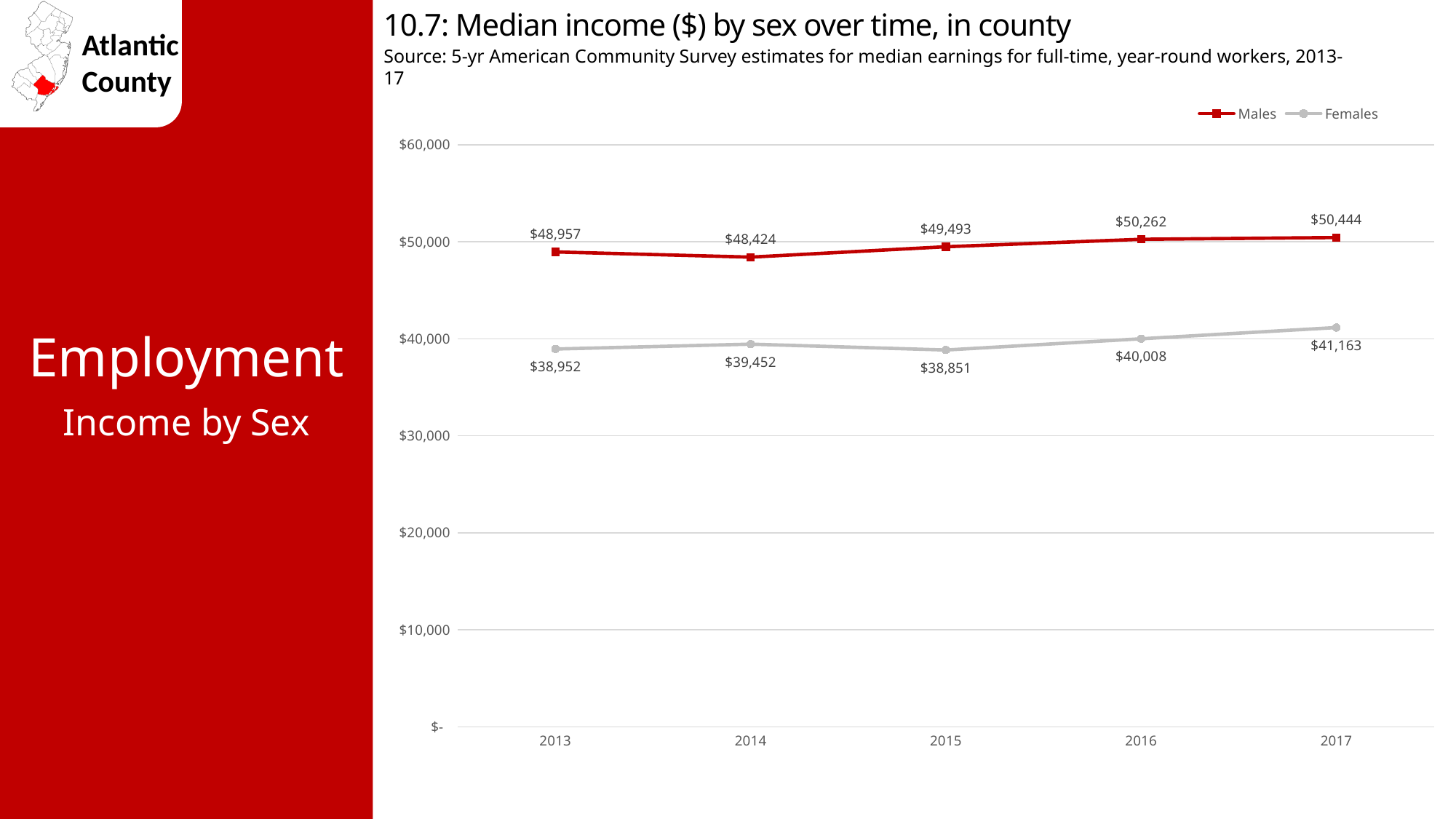
What is the difference between the Males and Females median income in 2017? $9,281 How many years are shown on the x axis? 5 Which series had the higher median income in 2016, Males or Females? Males What was the median income for Males in 2017? $50,444 Is the median income for Females in 2014 greater or less than $40,000? less In which year was the median income for Males lowest? 2014 Did the median income for Males rise or fall from 2014 to 2017? rise What kind of chart is shown on the slide? line chart What was the median income for Males in 2013? $48,957 What was the median income for Females in 2015? $38,851 How many series does the legend list? 2 In which year was the median income for Females highest? 2017